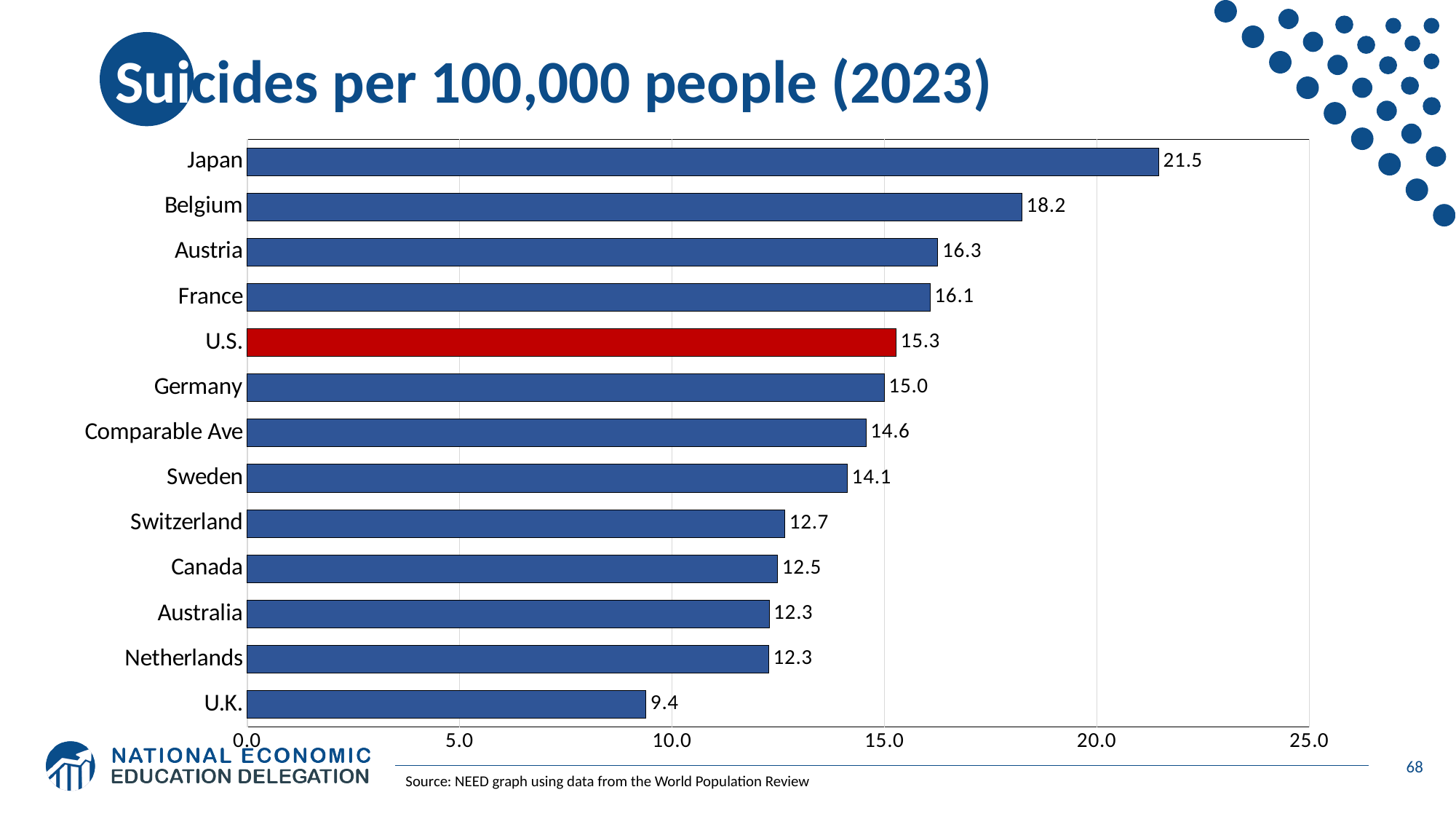
What is the value for the U.S.? 15.3 Which bar is coloured red rather than blue? U.S. What kind of chart is shown on the slide? Bar chart What is the difference between the values for the U.S. and the U.K.? 5.9 What is the value for Japan? 21.5 Which category has the lowest value? U.K. Is the value for Belgium greater or less than 15.0? greater What is the difference between the values for Japan and Belgium? 3.3 Which is larger, the value for Austria or the value for Sweden? Austria What is the value for Comparable Ave? 14.6 Which category has the highest value? Japan How many categories are shown on the chart? 13